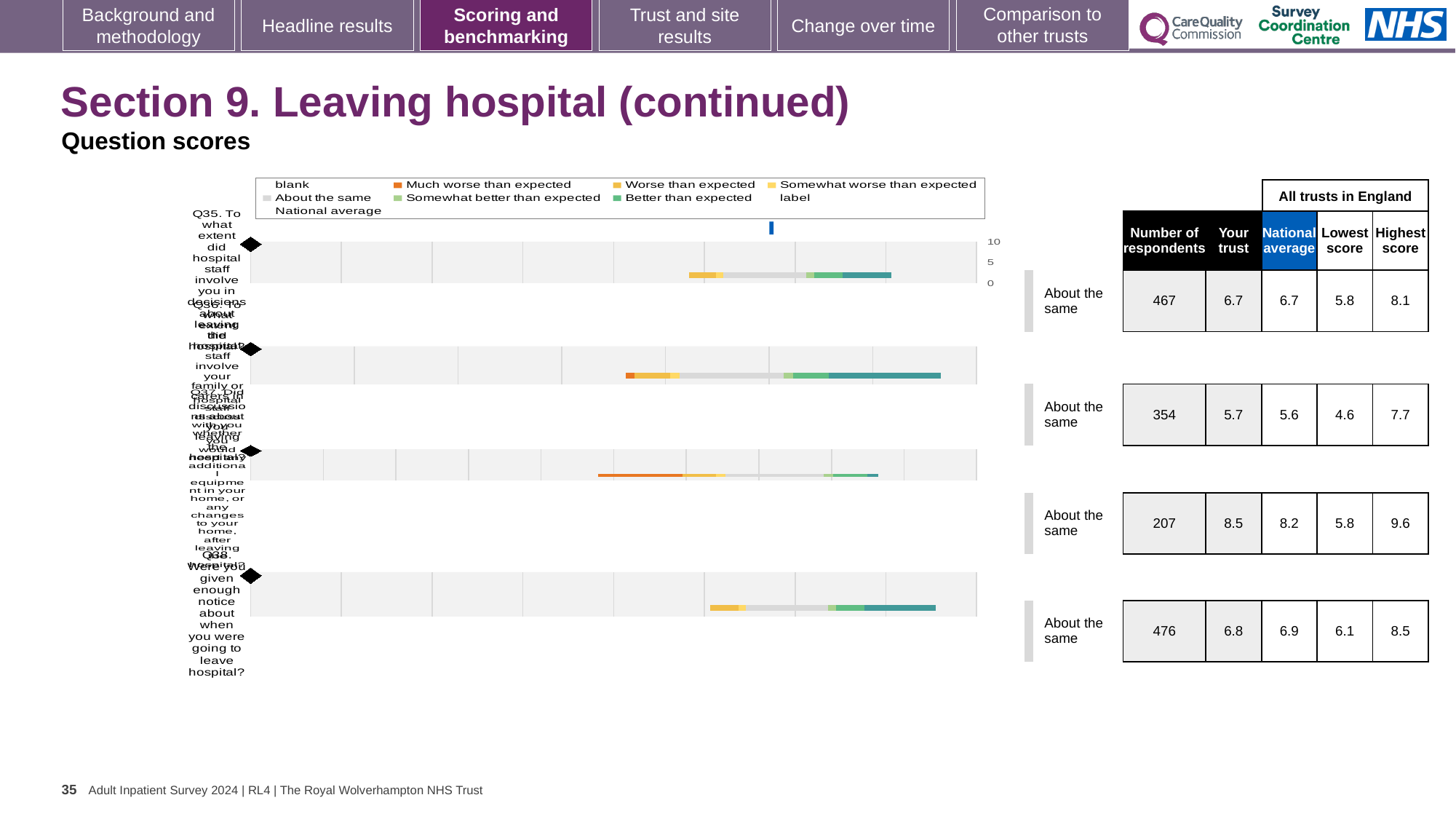
What is the highest tick value shown on the horizontal axis of the top chart? 10 Which question row has the lowest 'Your trust' score in the table beside the charts? Q36 What is the difference between the highest score (9.6) and the lowest score (5.8) for Q37 in the table beside the charts? 3.8 Is the 'Your trust' score for Q36 (5.7) larger or smaller than the national average for Q36 (5.6)? larger According to the table beside the charts, what is the national average for Q37 (discussing additional equipment or changes to your home)? 8.2 According to the table beside the charts, what is the 'Your trust' score for Q35 (involving you in decisions about leaving hospital)? 6.7 How many question rows (charts) are plotted on the slide? 4 According to the table beside the charts, what is the 'Your trust' score for Q38 (given enough notice about when you were going to leave hospital)? 6.8 Which question row has the highest 'Your trust' score in the table beside the charts? Q37 In the chart legend, which colour represents 'Much worse than expected'? orange What benchmark category is shown for all four question rows on this slide? About the same What kind of chart is used to show the benchmark results for each question on this slide? bar chart